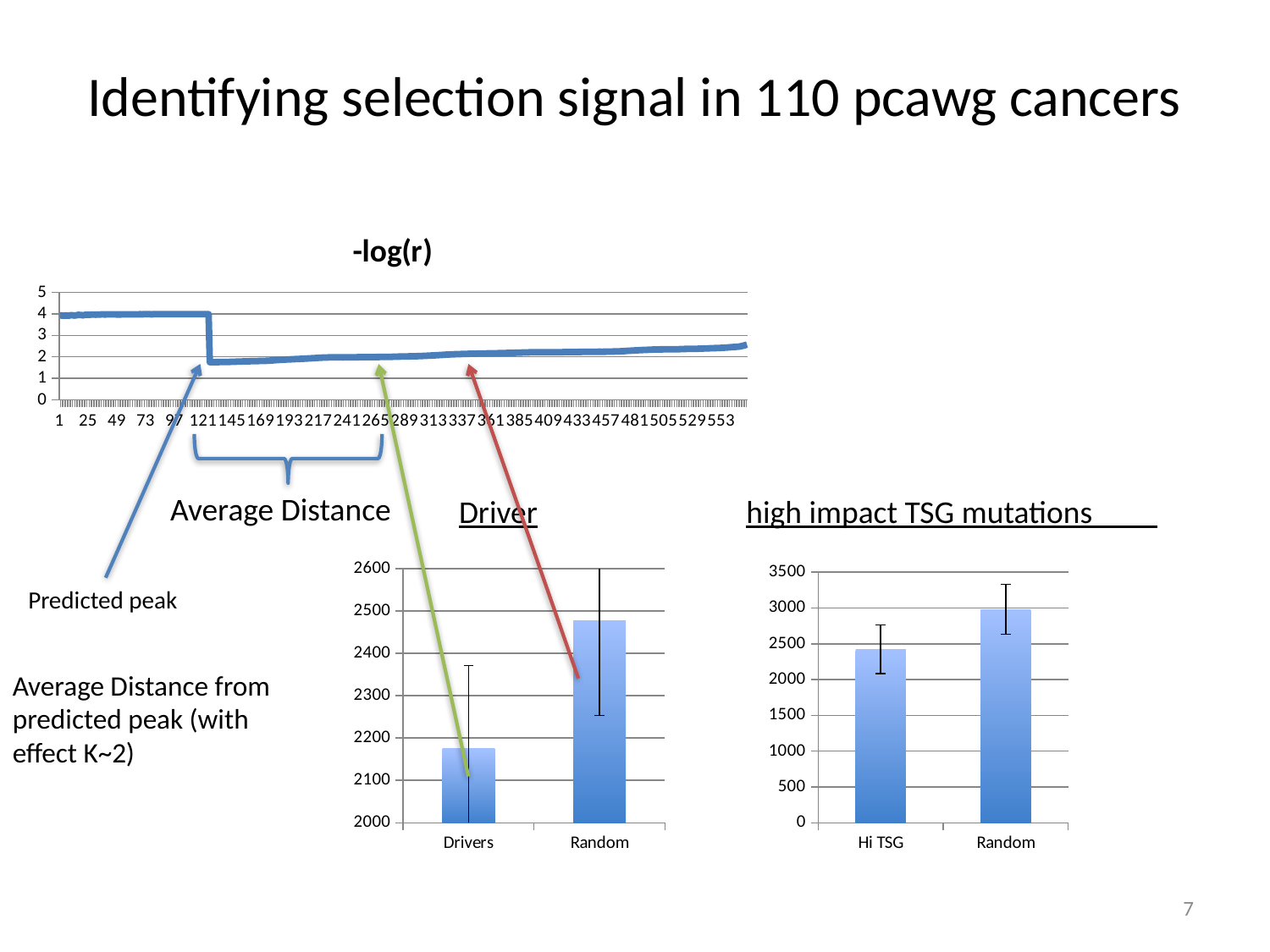
In the "Driver" chart, which bar is taller, Drivers or Random? Random What kind of chart is the "Driver" chart at the bottom centre of the slide? bar chart What kind of chart is the chart titled "-log(r)"? line chart What is the highest tick value shown on the y axis of the "high impact TSG mutations" chart? 3500 In the "-log(r)" chart, is the value at the start of the x axis (x = 1) greater or less than 3? greater In the "high impact TSG mutations" chart, is the value for Hi TSG greater or less than 2500? less In the "Driver" chart, is the value for Random greater or less than 2400? greater In the "high impact TSG mutations" chart, which category has the highest value? Random How many categories are shown on the x axis of the "Driver" chart? 2